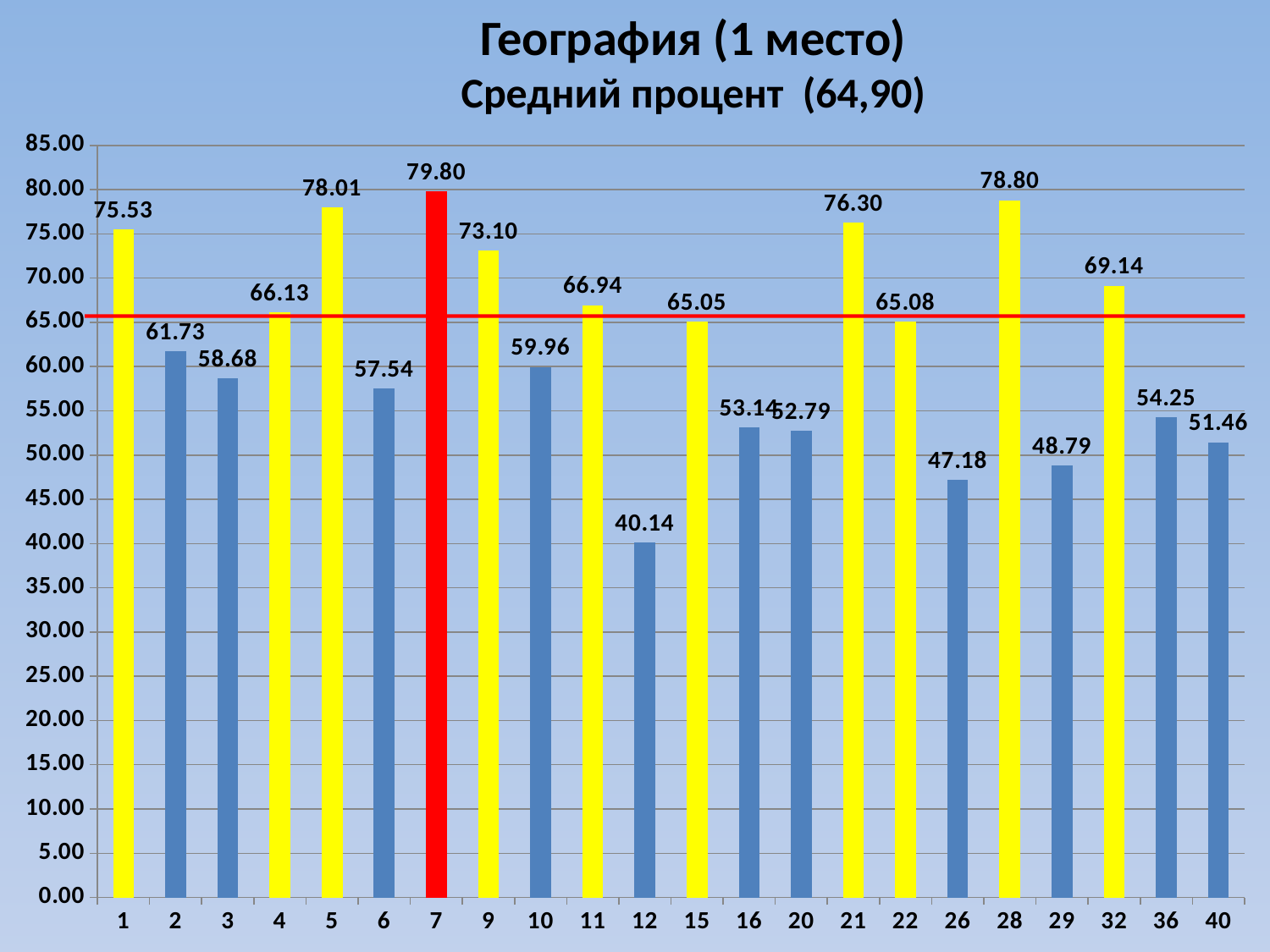
Which has the larger value, category 21 or category 22? 21 What colour is the bar for category 7? red What is the value for category 7? 79.80 Which category has the highest value? 7 What is the difference between the values for category 7 and category 12? 39.66 Is the value for category 26 greater or less than 50.00? less What is the value for category 28? 78.80 What is the difference between the values for category 1 and category 2? 13.80 What kind of chart is shown on the slide? bar chart What is the value for category 12? 40.14 Which category has the lowest value? 12 How many bars are shown in the chart? 22